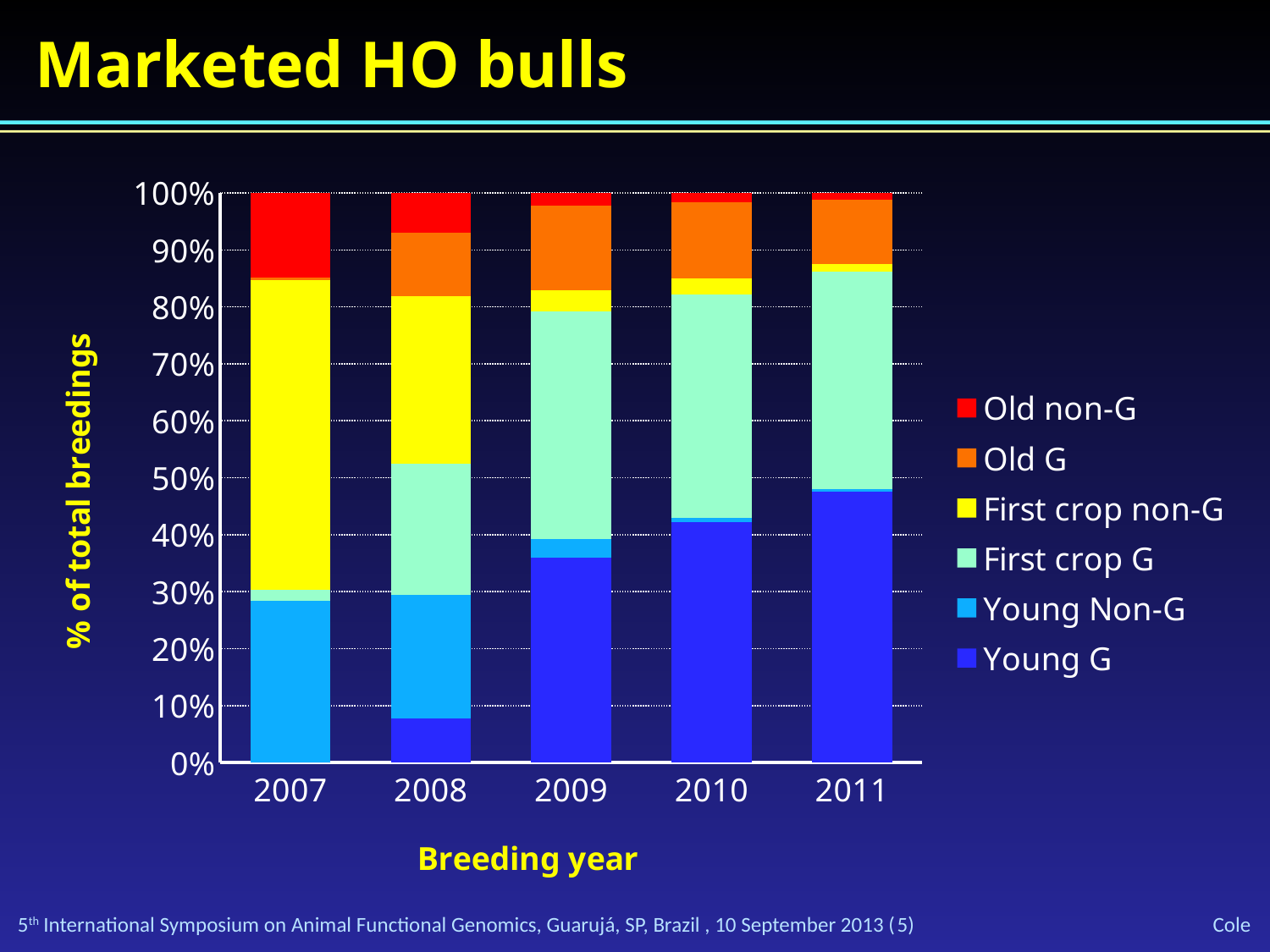
Is the First crop non-G share in 2007 greater or less than 50%? greater What is the label of the y axis? % of total breedings Which year has the larger First crop non-G share, 2007 or 2011? 2007 Is the Young Non-G share in 2007 greater or less than 20%? greater How many breeding years are shown on the x axis? 5 Is the Young G share in 2009 greater or less than 30%? greater What is the title of the chart? Marketed HO bulls In which breeding year is the Young G share highest? 2011 Does the Young G share rise or fall from 2007 to 2011? rise What kind of chart is shown on the slide? Stacked bar chart How many series does the legend list? 6